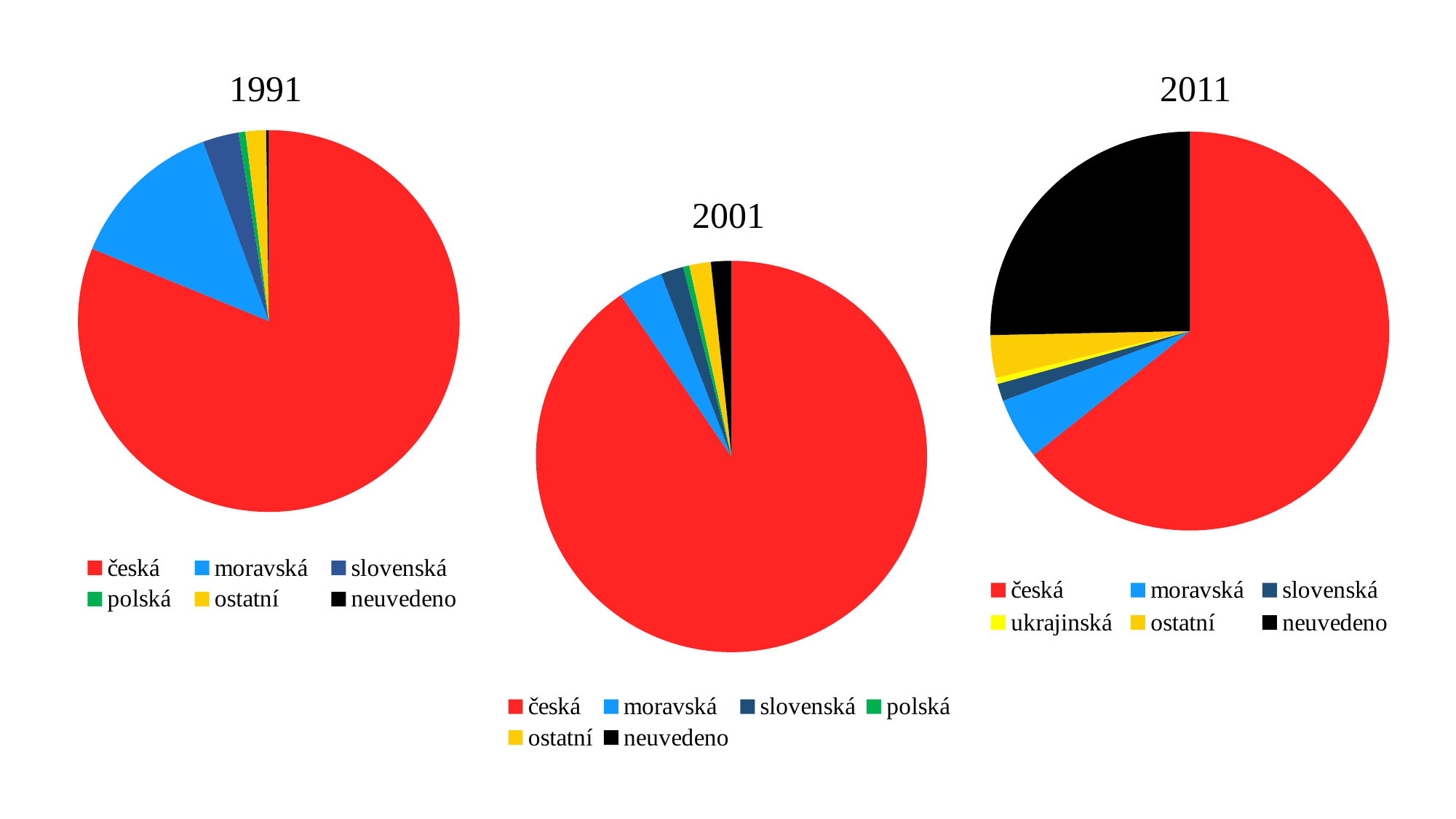
Which chart has the larger moravská slice: 1991 or 2001? 1991 Which of the three charts includes the category ukrajinská in its legend? 2011 In the 2011 chart, which category has the largest slice? česká In the 1991 chart, which category has the second-largest slice? moravská In the 1991 chart, how many categories does the legend list? 6 What kind of chart is used for the 1991 data? pie chart In the 2011 chart, which category has the second-largest slice? neuvedeno In the 2011 chart, what colour represents the neuvedeno category? black In the 2011 chart, which slice is larger: moravská or neuvedeno? neuvedeno In the 2011 chart, how many categories does the legend list? 6